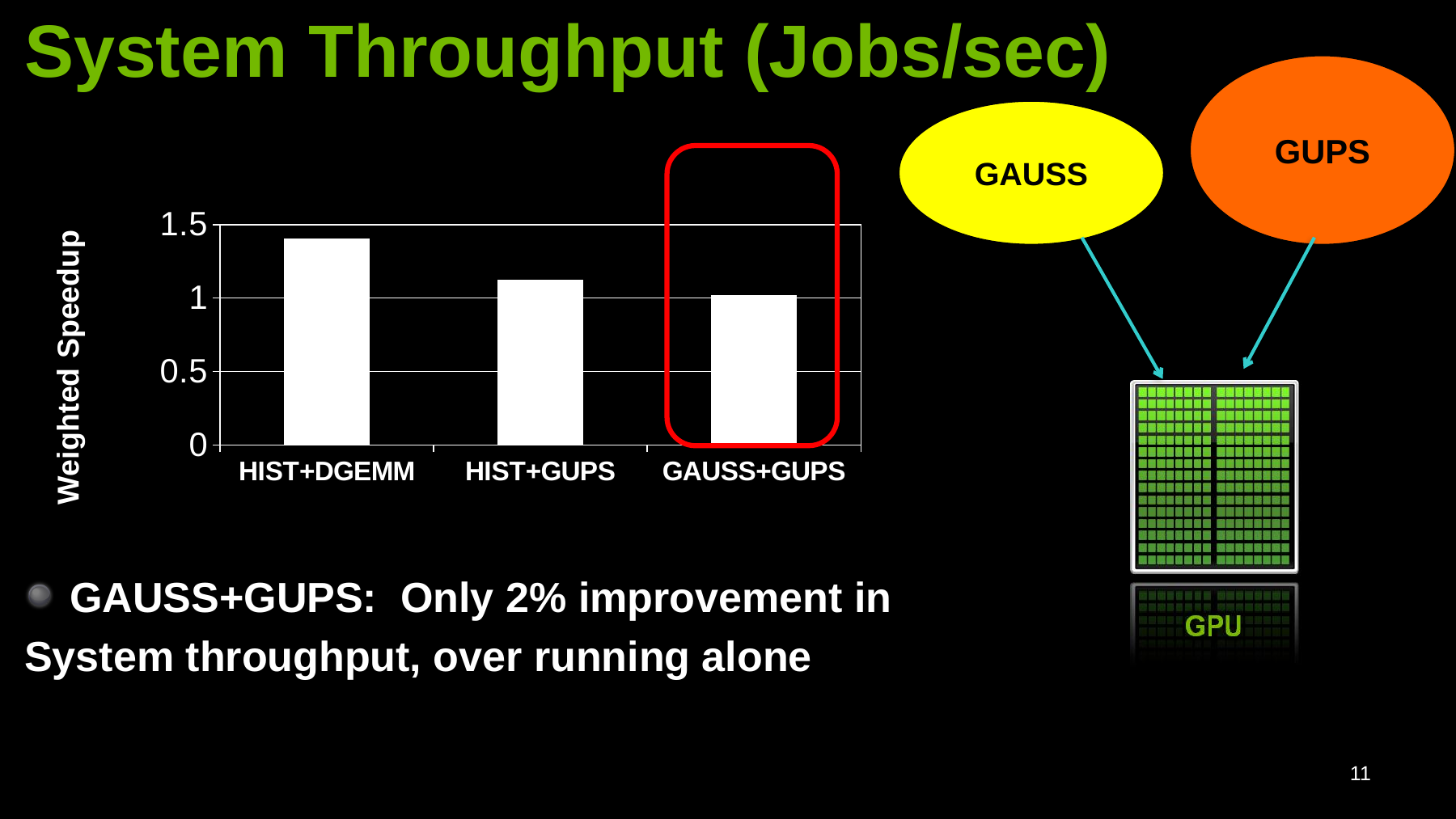
Which category's bar is outlined with a red box? GAUSS+GUPS Which category has the highest weighted speedup? HIST+DGEMM Which has the larger weighted speedup, HIST+DGEMM or HIST+GUPS? HIST+DGEMM Which category has the lowest weighted speedup? GAUSS+GUPS Is the weighted speedup for HIST+GUPS greater or less than 1? greater How many categories are plotted on the x axis of the chart? 3 What is the label on the y axis of the chart? Weighted Speedup Is the weighted speedup for HIST+DGEMM greater or less than 1? greater Is the weighted speedup for GAUSS+GUPS greater or less than 0.5? greater What kind of chart is shown on the slide? bar chart Do the bar values rise or fall from left to right across the x axis? fall